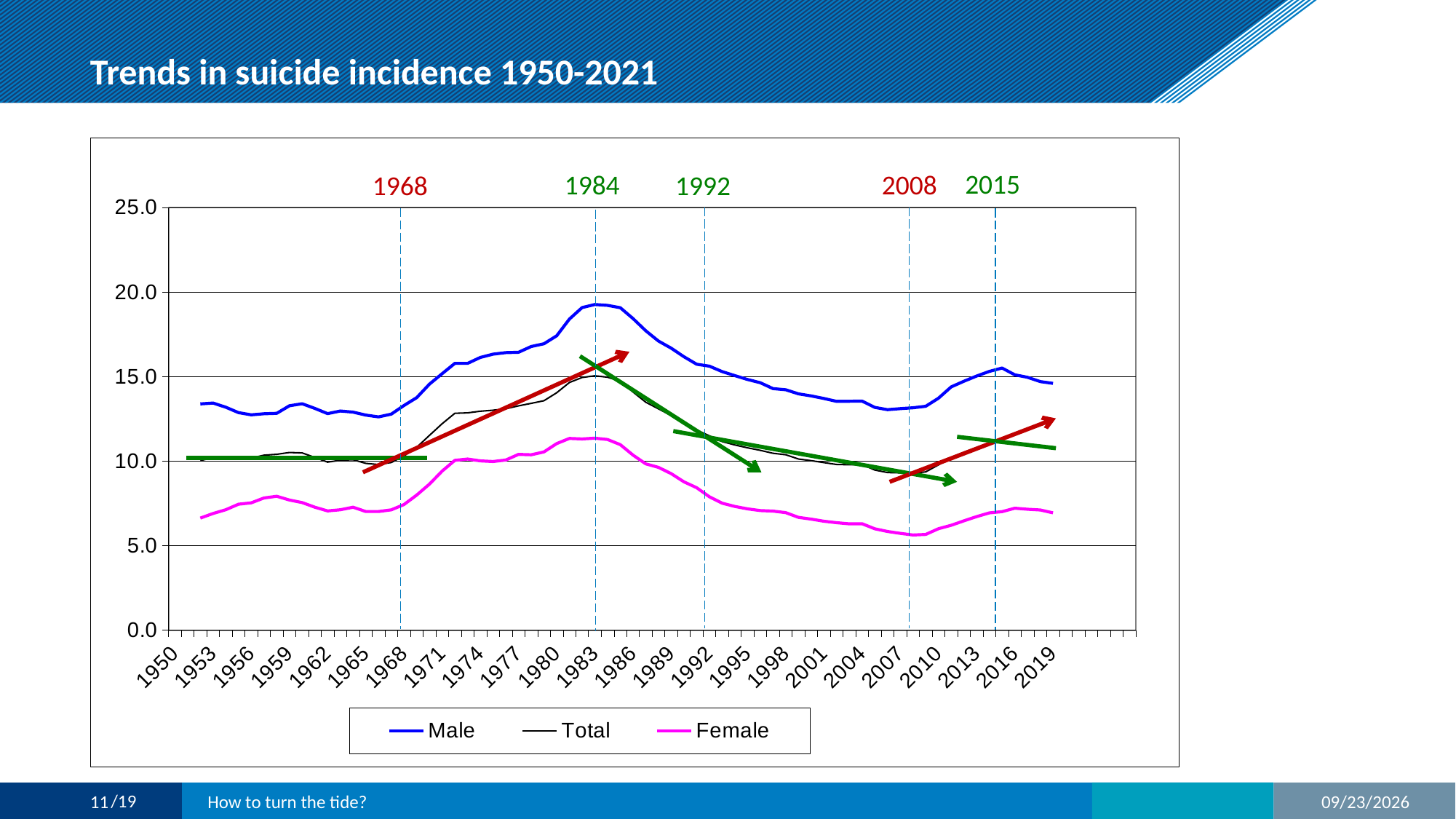
Does the Female series rise or fall between 1992 and 2008? Fall How many series does the legend list? 3 Which series is plotted with the pink line? Female What is the title of the chart? Trends in suicide incidence 1950-2021 What kind of chart is shown on the slide? Line chart Which series has the higher value in 1983, Male or Female? Male Is the value for Female in 2008 greater or less than 10.0? less Is the value for Male in 2019 greater or less than 20.0? less Is the value for Male in 1983 greater or less than 15.0? greater Which series has the lowest values across the whole period? Female